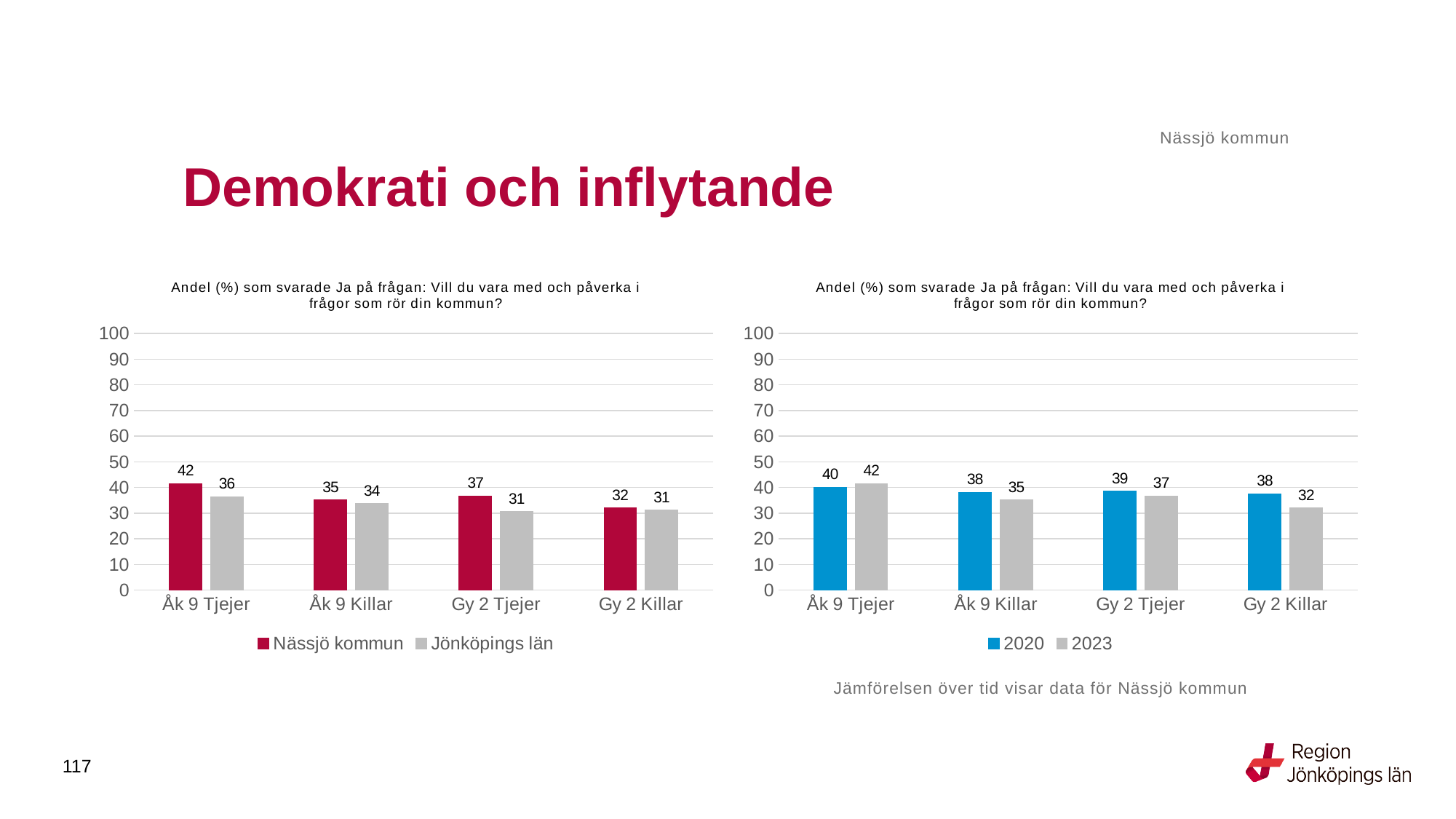
In the left chart, which category has the highest value for Nässjö kommun? Åk 9 Tjejer In the right chart, what is the difference between the 2020 and 2023 values for Gy 2 Killar? 6 In the left chart, what is the value for Jönköpings län for Gy 2 Tjejer? 31 In the left chart, what is the difference between Nässjö kommun and Jönköpings län for Åk 9 Tjejer? 6 In the left chart, which category has the lowest value for Nässjö kommun? Gy 2 Killar In the right chart, what is the value for 2020 for Åk 9 Killar? 38 In the right chart, what is the value for 2023 for Gy 2 Killar? 32 What kind of chart is the right chart? Bar chart In the right chart, which is larger for Åk 9 Tjejer: the 2020 value or the 2023 value? 2023 How many categories are shown on the x axis of the right chart? 4 How many series does the legend of the left chart list? 2 In the left chart, what is the value for Nässjö kommun for Åk 9 Tjejer? 42